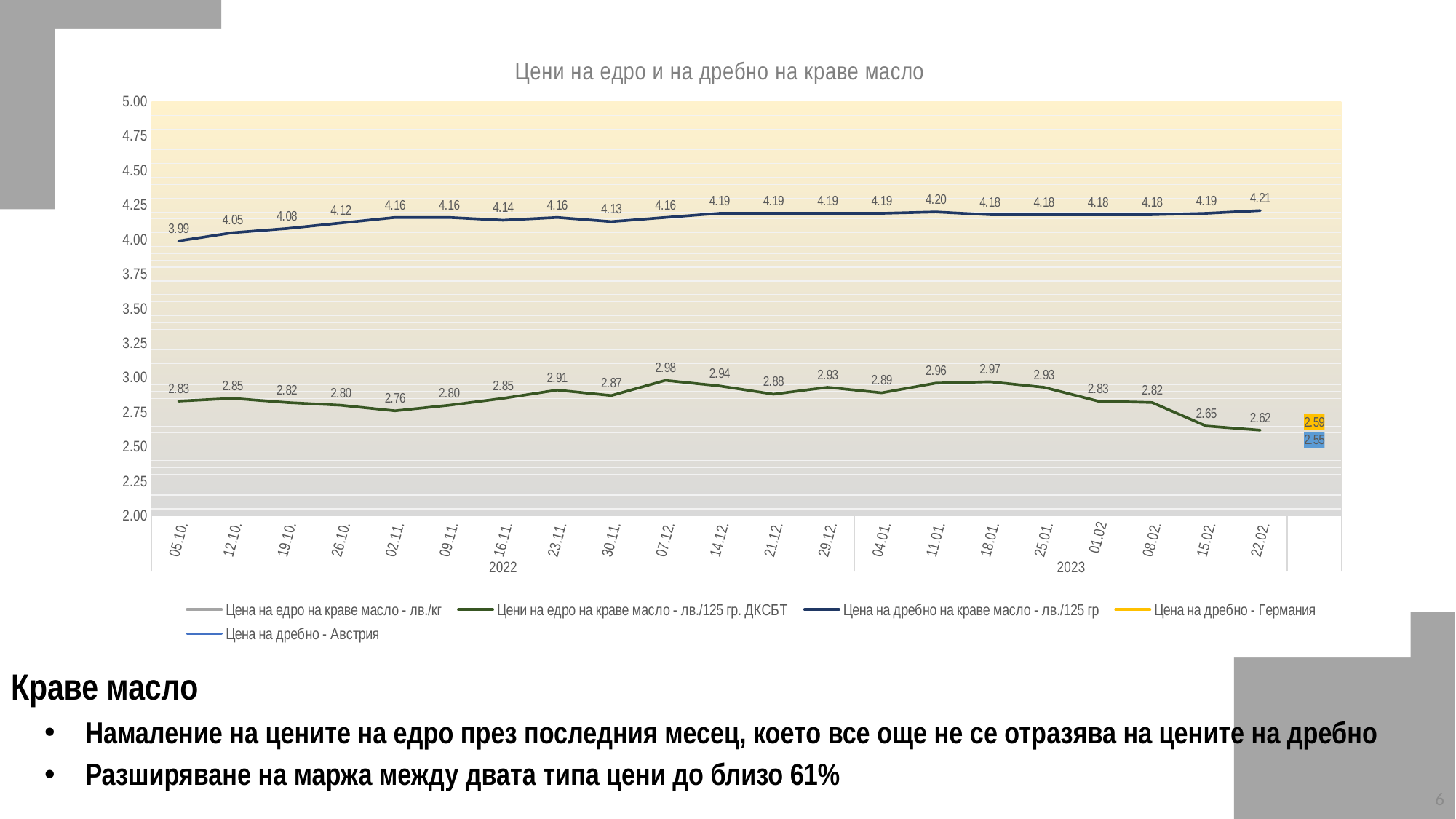
How many series does the legend list? 5 What is the difference between the retail price and the wholesale price (ДКСБТ) on 22.02.2023? 1.59 What type of chart is shown on the slide? line chart What is the value of the retail price series (Цена на дребно на краве масло - лв./125 гр) on 22.02.2023? 4.21 What is the value of the wholesale price series (Цени на едро на краве масло - лв./125 гр. ДКСБТ) on 05.10.2022? 2.83 What is the title of the chart? Цени на едро и на дребно на краве масло What is the value shown for Цена на дребно - Австрия? 2.55 On which date does the wholesale price series (ДКСБТ) reach its highest value? 07.12. Does the wholesale price series (ДКСБТ) rise or fall between 08.02.2023 and 22.02.2023? fall What is the value shown for Цена на дребно - Германия? 2.59 On which date does the wholesale price series (ДКСБТ) reach its lowest value? 22.02. What is the value of the wholesale price series (ДКСБТ) on 07.12.2022? 2.98